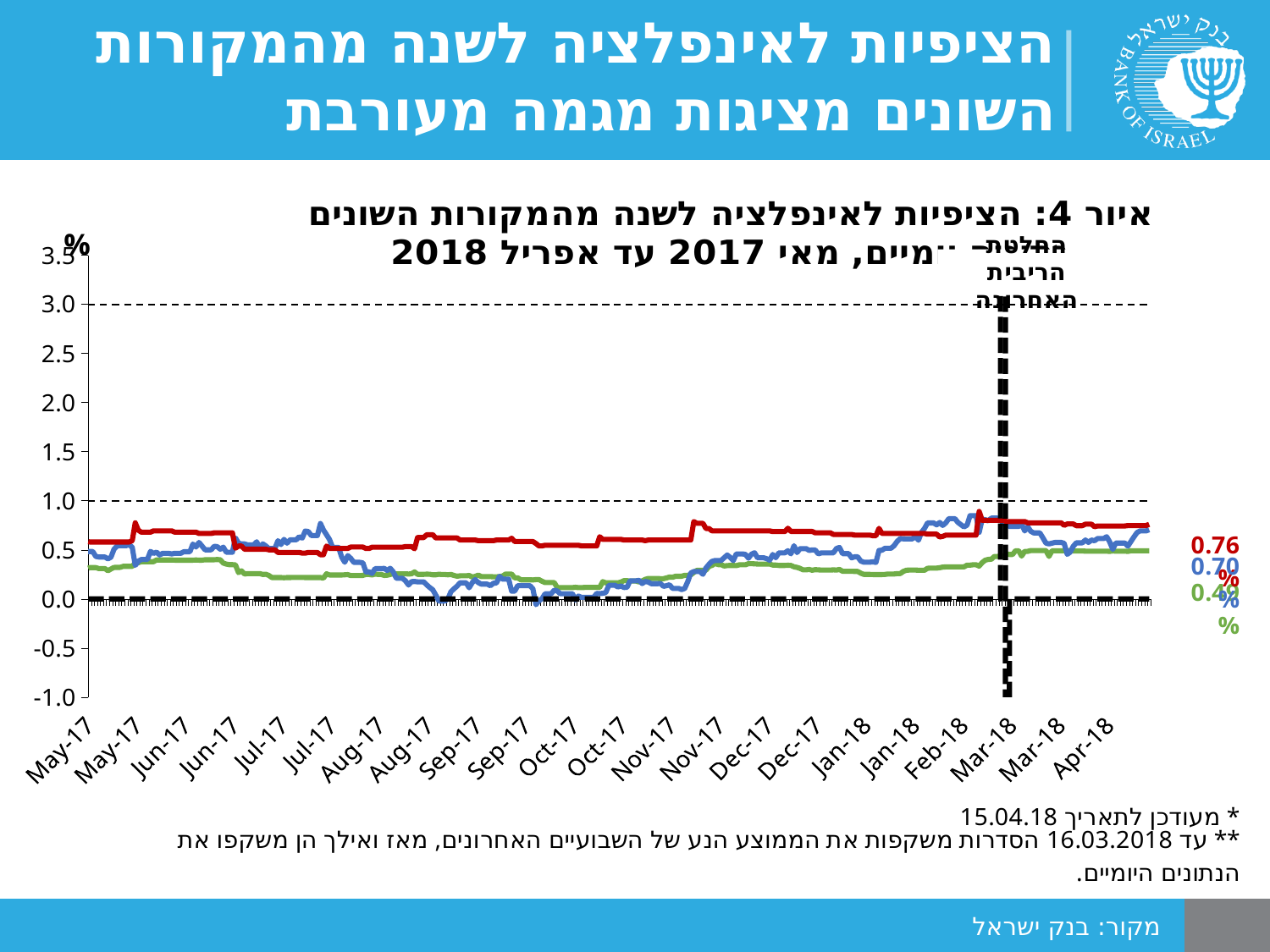
Does the blue line rise or fall between Sep-17 and Feb-18? rise Is the value of the green line around Sep-17 greater or less than 0.5? less How many lines are plotted on the chart? 3 What kind of chart is shown on the slide? line chart Which line has the lowest labelled end value? the green line (0.49%) Which line has the highest labelled end value? the red line (0.76%) What is the final value labelled for the blue line at the right end of the chart? 0.70% What is the final value labelled for the red line at the right end of the chart? 0.76% What is the final value labelled for the green line at the right end of the chart? 0.49% What is the highest tick value shown on the vertical axis? 3.5 What is the difference between the labelled end values of the red line and the green line? 0.27% Is the labelled end value of the blue line larger or smaller than that of the green line? larger